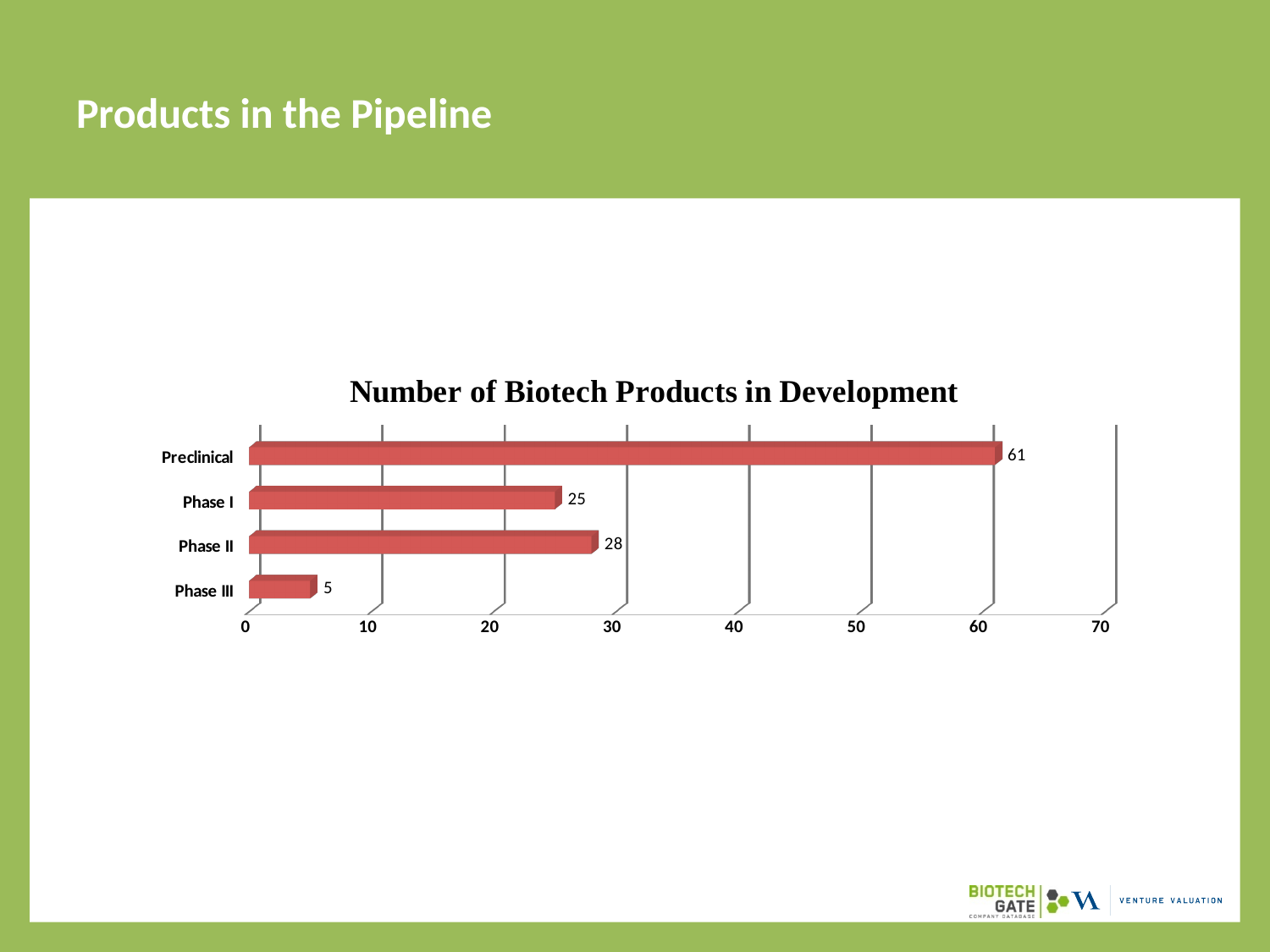
What is the difference between the Preclinical and Phase III values? 56 What is the number of biotech products in development at the Preclinical stage? 61 Which is larger, the value for Phase I or the value for Phase II? Phase II How many categories are shown in the chart? 4 Which category has the lowest number of products in development? Phase III What is the value for Phase I? 25 What kind of chart is shown on the slide? Bar chart Which category has the highest number of products in development? Preclinical What is the difference between the Phase II and Phase I values? 3 What is the value for Phase III? 5 What is the value for Phase II? 28 What is the title of the chart? Number of Biotech Products in Development